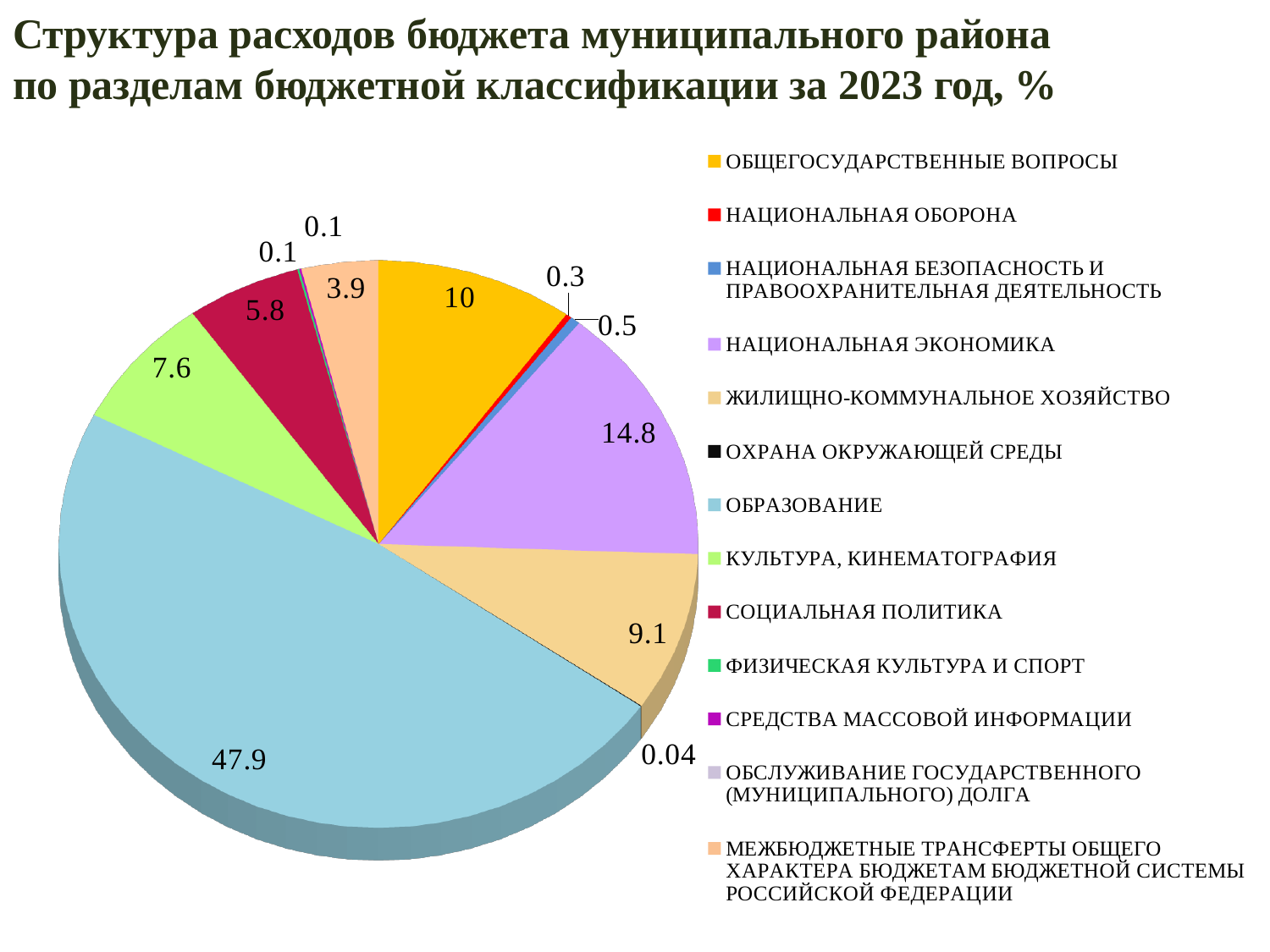
What is the share for ОБЩЕГОСУДАРСТВЕННЫЕ ВОПРОСЫ? 10 What is the difference between the shares for ОБРАЗОВАНИЕ and НАЦИОНАЛЬНАЯ ЭКОНОМИКА? 33.1 What is the share for ЖИЛИЩНО-КОММУНАЛЬНОЕ ХОЗЯЙСТВО? 9.1 What is the title of the chart? Структура расходов бюджета муниципального района по разделам бюджетной классификации за 2023 год, % What is the share for КУЛЬТУРА, КИНЕМАТОГРАФИЯ? 7.6 How many categories does the legend list? 13 Which category has the largest share of the pie? ОБРАЗОВАНИЕ What is the share for НАЦИОНАЛЬНАЯ ЭКОНОМИКА? 14.8 Which is larger, the share for НАЦИОНАЛЬНАЯ ЭКОНОМИКА or the share for ЖИЛИЩНО-КОММУНАЛЬНОЕ ХОЗЯЙСТВО? НАЦИОНАЛЬНАЯ ЭКОНОМИКА What is the share for ОБРАЗОВАНИЕ? 47.9 What kind of chart is shown on the slide? pie chart What is the share for СОЦИАЛЬНАЯ ПОЛИТИКА? 5.8